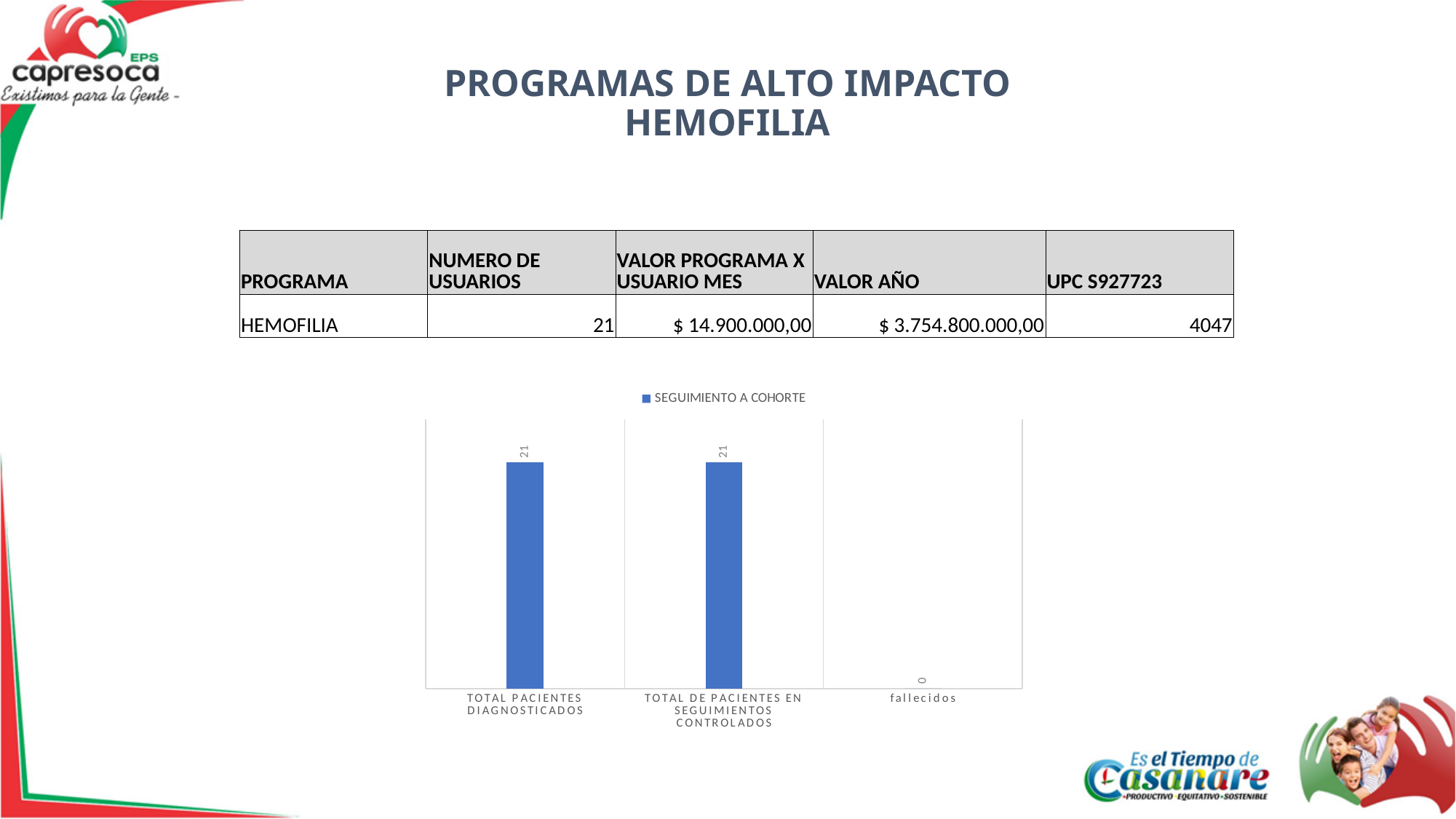
What is the value for TOTAL DE PACIENTES EN SEGUIMIENTOS CONTROLADOS? 21 Which is larger, the value for TOTAL DE PACIENTES EN SEGUIMIENTOS CONTROLADOS or the value for fallecidos? TOTAL DE PACIENTES EN SEGUIMIENTOS CONTROLADOS What colour are the bars in the chart? blue How many categories are shown on the x axis? 3 Do the values rise or fall from TOTAL DE PACIENTES EN SEGUIMIENTOS CONTROLADOS to fallecidos? fall How many series does the legend list? 1 What is the name of the series in the legend? SEGUIMIENTO A COHORTE What is the value for TOTAL PACIENTES DIAGNOSTICADOS? 21 Which category has the lowest value? fallecidos What is the difference between TOTAL PACIENTES DIAGNOSTICADOS and fallecidos? 21 What kind of chart is shown? bar chart What is the value for fallecidos? 0